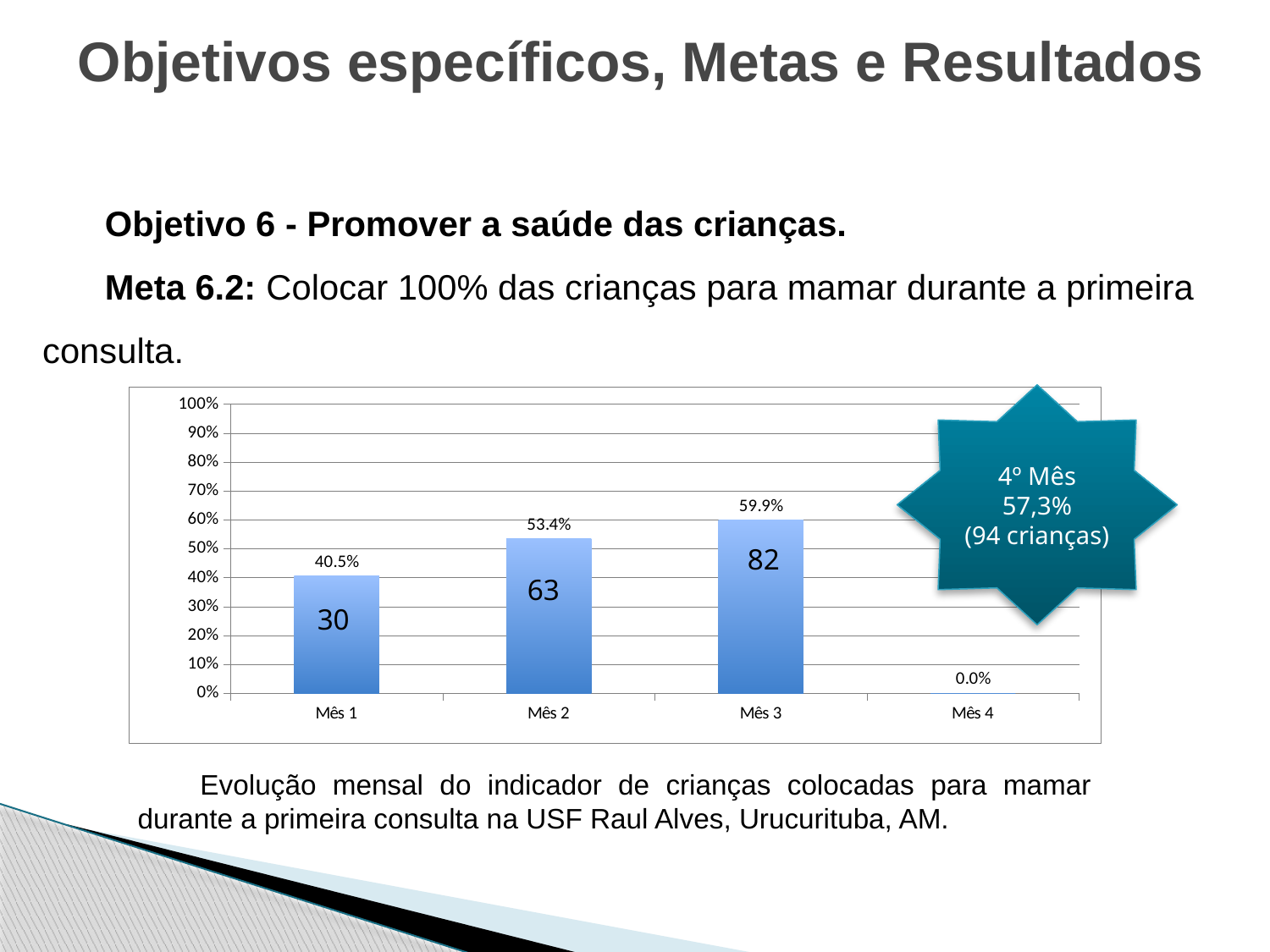
What is the difference in percentage points between Mês 3 and Mês 1? 19.4 What number is printed inside the bar for Mês 3? 82 What kind of chart is shown on the slide? Bar chart Which is larger, the percentage for Mês 2 or for Mês 1? Mês 2 Do the percentages rise or fall from Mês 1 to Mês 3? Rise What percentage is shown for Mês 1? 40.5% What percentage is shown for Mês 3? 59.9% Which month has the highest percentage in the chart? Mês 3 What number is printed inside the bar for Mês 1? 30 What percentage is shown for Mês 2? 53.4% How many months are shown on the x axis of the chart? 4 Which month has the lowest percentage in the chart? Mês 4